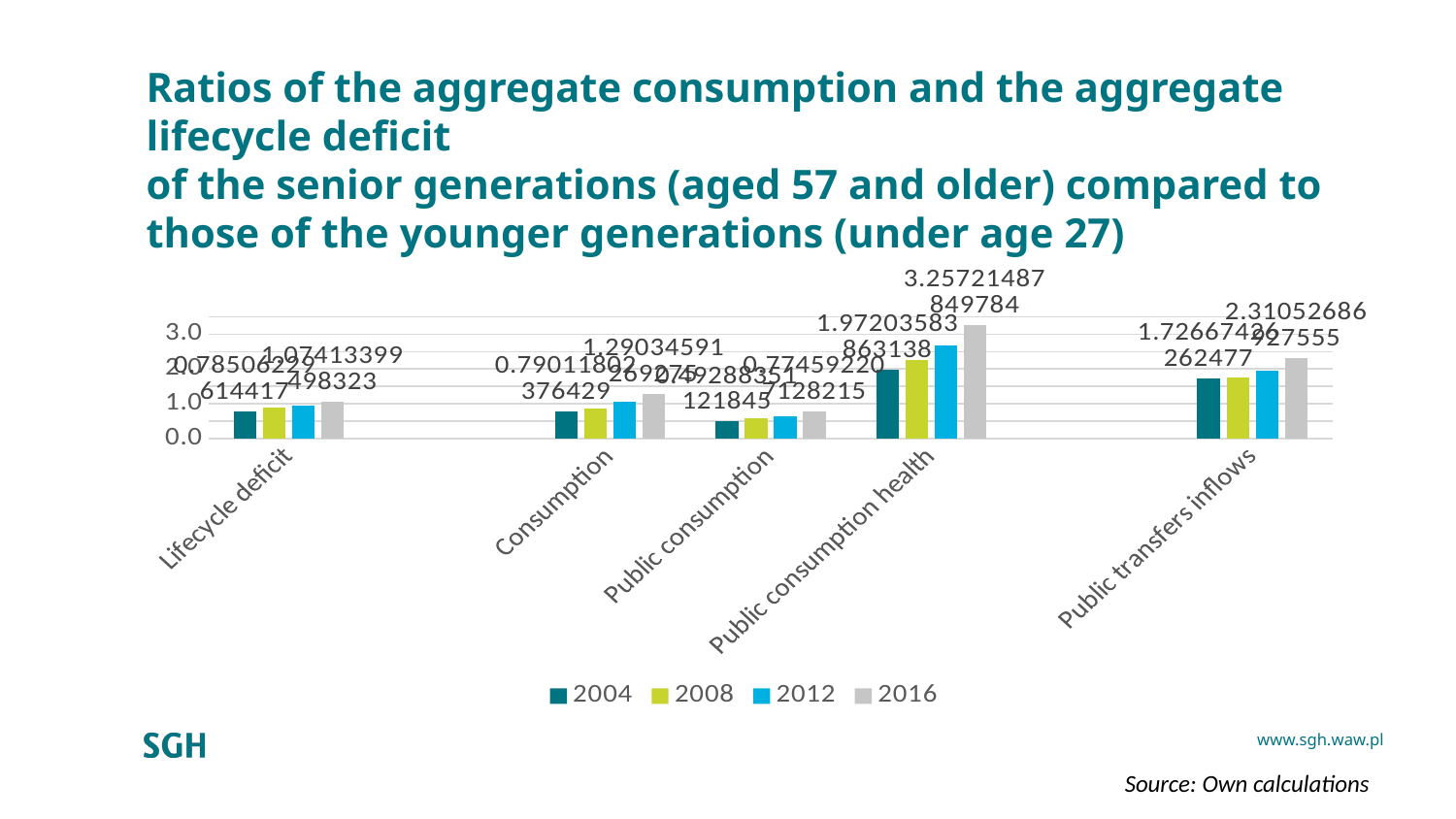
Within Public consumption health, which year has the highest value? 2016 Is the value for Lifecycle deficit in 2004 greater or less than 1.0? less How many series does the legend list? 4 Is the value for Public consumption health in 2016 greater or less than 3.0? greater How many categories are shown on the x axis of the chart? 5 Which category has the lowest bars in the chart? Public consumption Which category has the highest bar in the chart? Public consumption health What kind of chart is shown on the slide? bar chart What is the value for Public consumption health in 2016? 3.25721487849784 Is the value for Public transfers inflows in 2004 greater or less than 1.0? greater Do the values for Public consumption health rise or fall from 2004 to 2016? rise Which years are listed in the chart legend? 2004, 2008, 2012, 2016